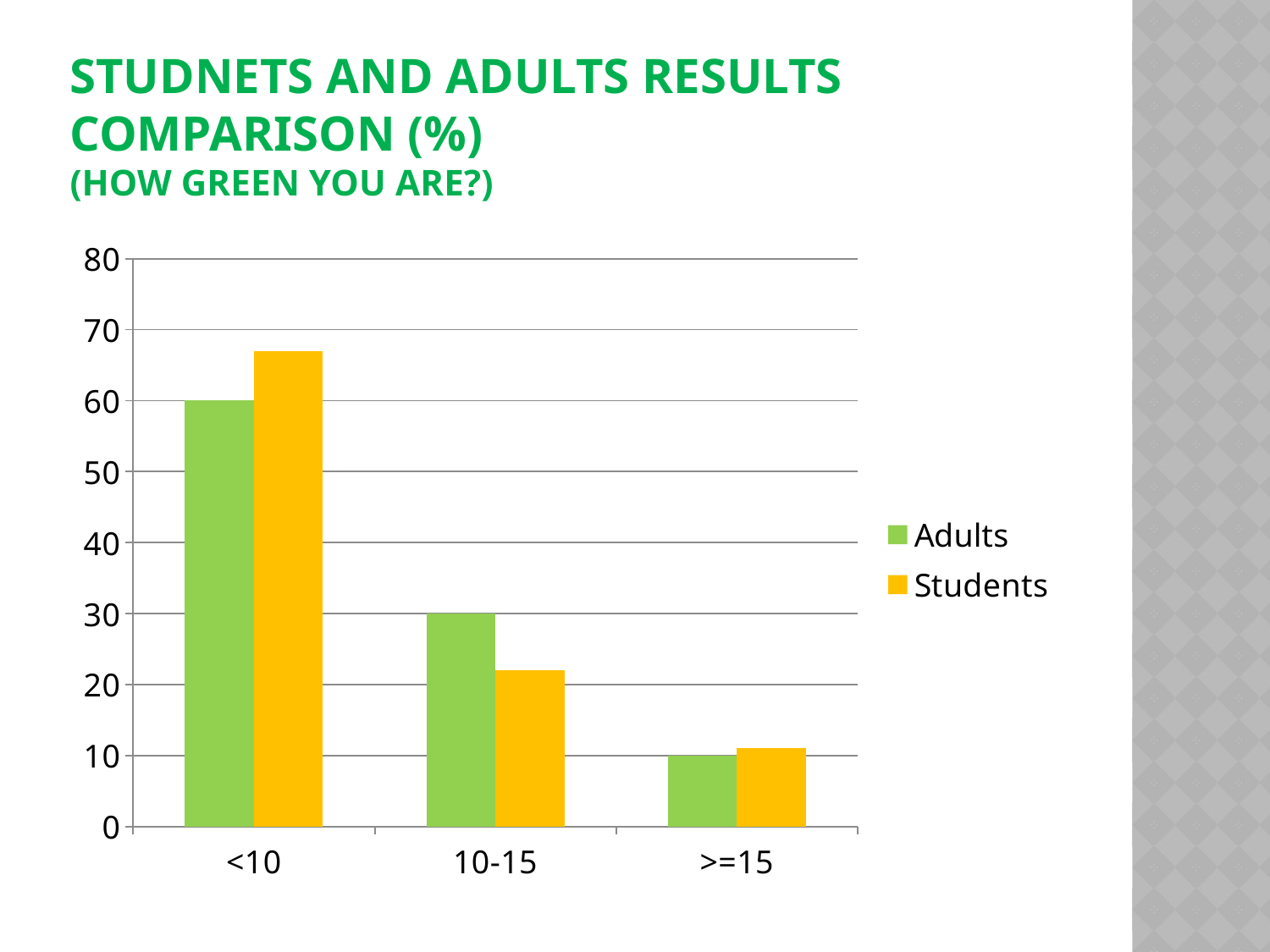
What kind of chart is shown on the slide? bar chart In the <10 category, which series has the larger value, Adults or Students? Students Which category has the highest value for Students? <10 Is the value for Students in the 10-15 category greater or less than 30? less In the 10-15 category, which series has the larger value, Adults or Students? Adults What is the value for Adults in the <10 category? 60 What is the value for Adults in the >=15 category? 10 What is the value for Adults in the 10-15 category? 30 Is the value for Students in the <10 category greater or less than 60? greater How many categories are shown on the x axis? 3 Do the Adults values rise or fall from left to right along the x axis? fall How many series does the legend list? 2